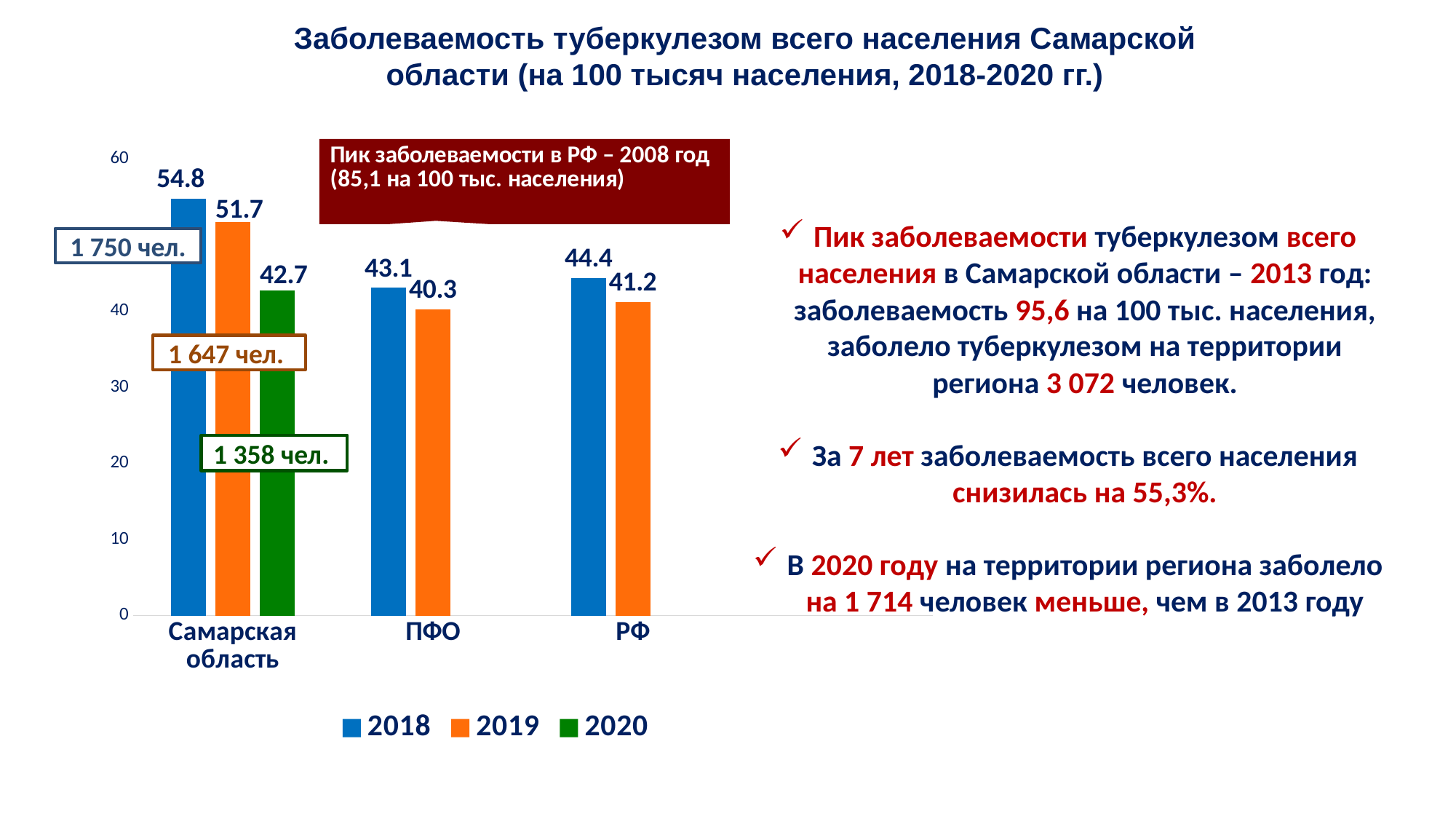
Which is larger, the 2019 value for РФ or the 2019 value for ПФО? РФ What is the 2018 value for РФ? 44.4 What is the difference between the 2018 and 2020 values for Самарская область? 12.1 How many series does the legend list? 3 How many categories are shown on the x axis? 3 What is the 2019 value for ПФО? 40.3 What is the 2018 value for Самарская область? 54.8 What kind of chart is shown on the slide? bar chart Which category has the lowest 2019 value? ПФО Do the values for Самарская область rise or fall from 2018 to 2020? fall Which category has the highest 2018 value? Самарская область What is the 2020 value for Самарская область? 42.7